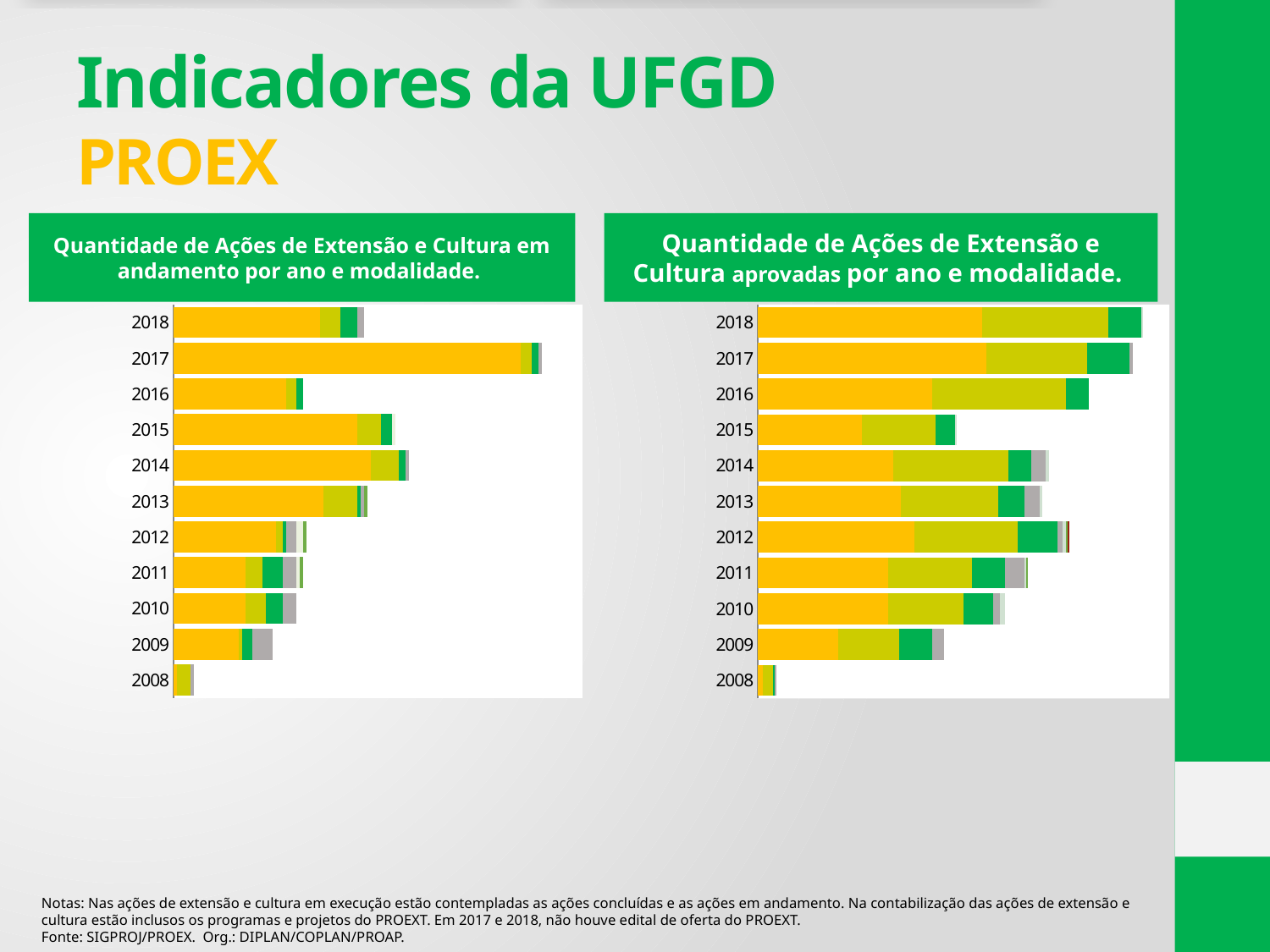
On the right chart (ações aprovadas), which year has the longer total bar, 2009 or 2012? 2012 What is the earliest year shown on the right chart (ações aprovadas)? 2008 On the left chart (ações em andamento), which year has the longer total bar, 2014 or 2016? 2014 On the right chart (ações aprovadas), which year has the longer total bar, 2015 or 2016? 2016 On the left chart (ações em andamento), which year has the shortest total bar? 2008 On the left chart (ações em andamento), which year has the longest total bar? 2017 How many years are shown on the left chart (ações em andamento)? 11 On the right chart (ações aprovadas), which year has the shortest total bar? 2008 How many years are shown on the right chart (ações aprovadas)? 11 What is the title of the right chart? Quantidade de Ações de Extensão e Cultura aprovadas por ano e modalidade. What kind of chart is the left chart, 'Quantidade de Ações de Extensão e Cultura em andamento por ano e modalidade'? Stacked bar chart